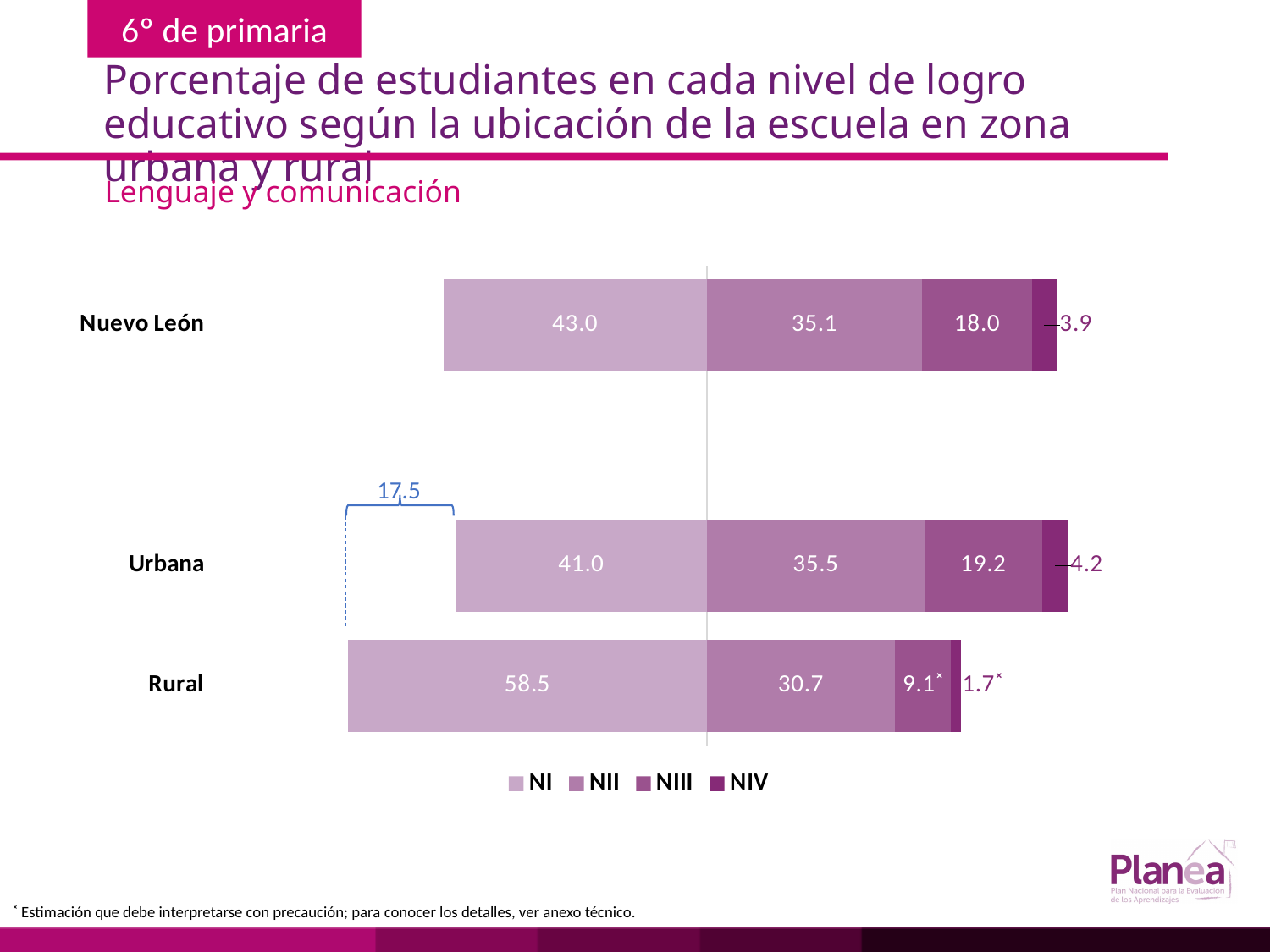
What is the NIV value for Rural? 1.7 What is the NIII value for Urbana? 19.2 What is the NII value for Nuevo León? 35.1 How many series does the legend list? 4 Which is larger, the NIV value for Urbana or for Nuevo León? Urbana What is the difference between the NI values for Rural and Urbana? 17.5 What is the total of the NI and NII values for Urbana? 76.5 What kind of chart is shown on the slide? Stacked bar chart Which category has the highest NI value? Rural What is the NI value for Rural? 58.5 Which category has the lowest NIII value? Rural How many categories are shown on the chart? 3